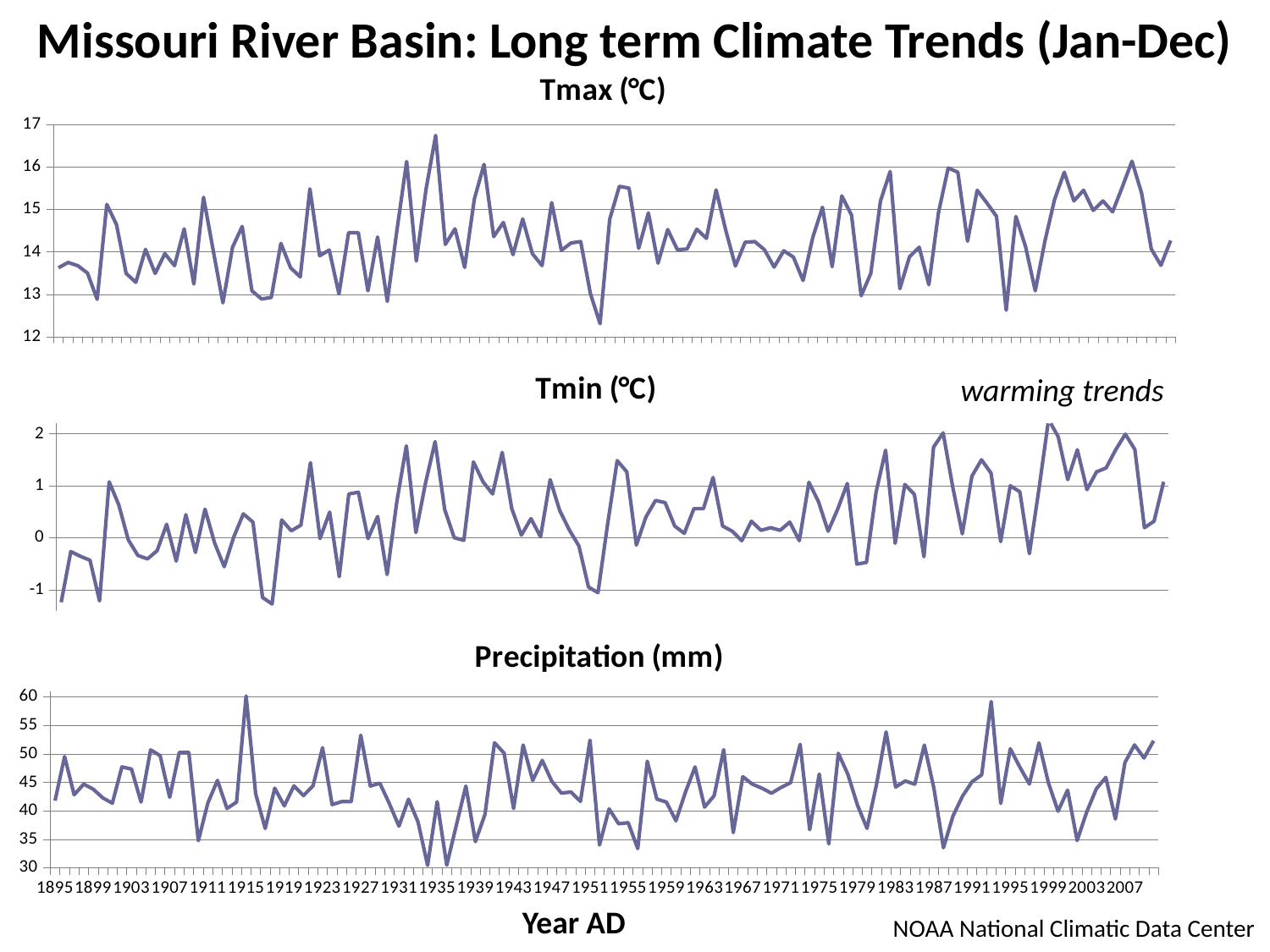
What kind of chart is the Precipitation (mm) chart? line chart In the Precipitation (mm) chart, is the peak value around 1915 greater or less than 55? greater In the Tmax (°C) chart, is the lowest value (around 1951) greater or less than 13? less What kind of chart is the Tmax (°C) chart? line chart What is the first year labeled on the x axis of the Precipitation (mm) chart? 1895 In the Tmin (°C) chart, do the values generally rise or fall from 1895 to 2007? rise What annotation is written next to the Tmin (°C) chart title? warming trends In the Tmin (°C) chart, is the peak value around 1999 greater or less than 2? greater How many charts are shown on the slide? 3